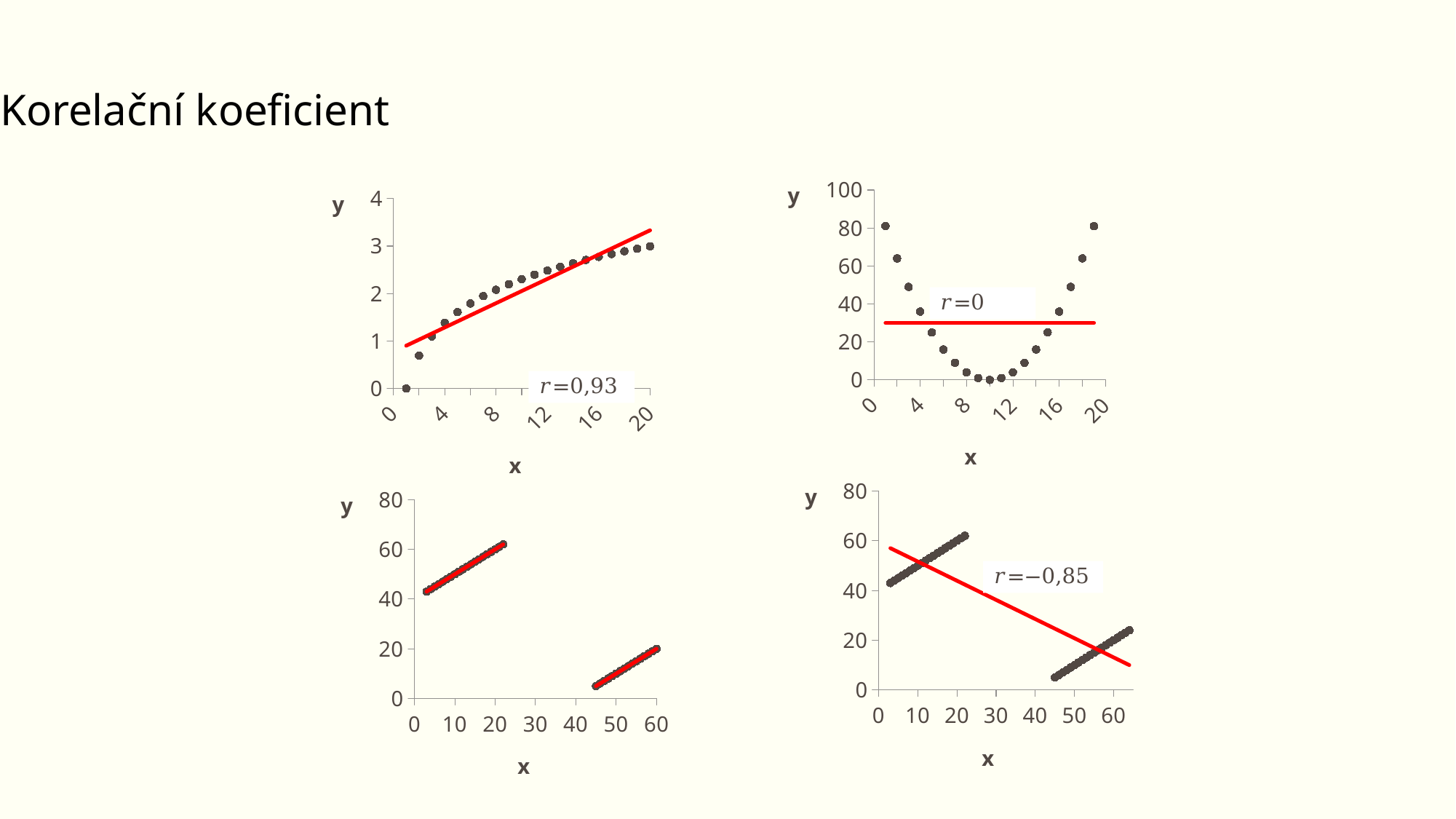
In the bottom-right chart, are the y values of the points near x=20 greater or less than 40? greater In the top-left chart, what correlation coefficient r is printed? r=0,93 In the top-right chart, is the y value of the first point (near x=0) greater or less than 60? greater In the bottom-left chart, are the y values of the points near x=50 greater or less than 40? less How many charts are shown on the slide? 4 What kind of chart is the top-left chart? scatter chart In the bottom-right chart, what correlation coefficient r is printed? r=−0,85 In the top-left chart, which is larger: the y value at x=4 or the y value at x=16? x=16 In the top-left chart, do the y values rise or fall as x increases? rise In the bottom-right chart, does the red trend line rise or fall as x increases? fall